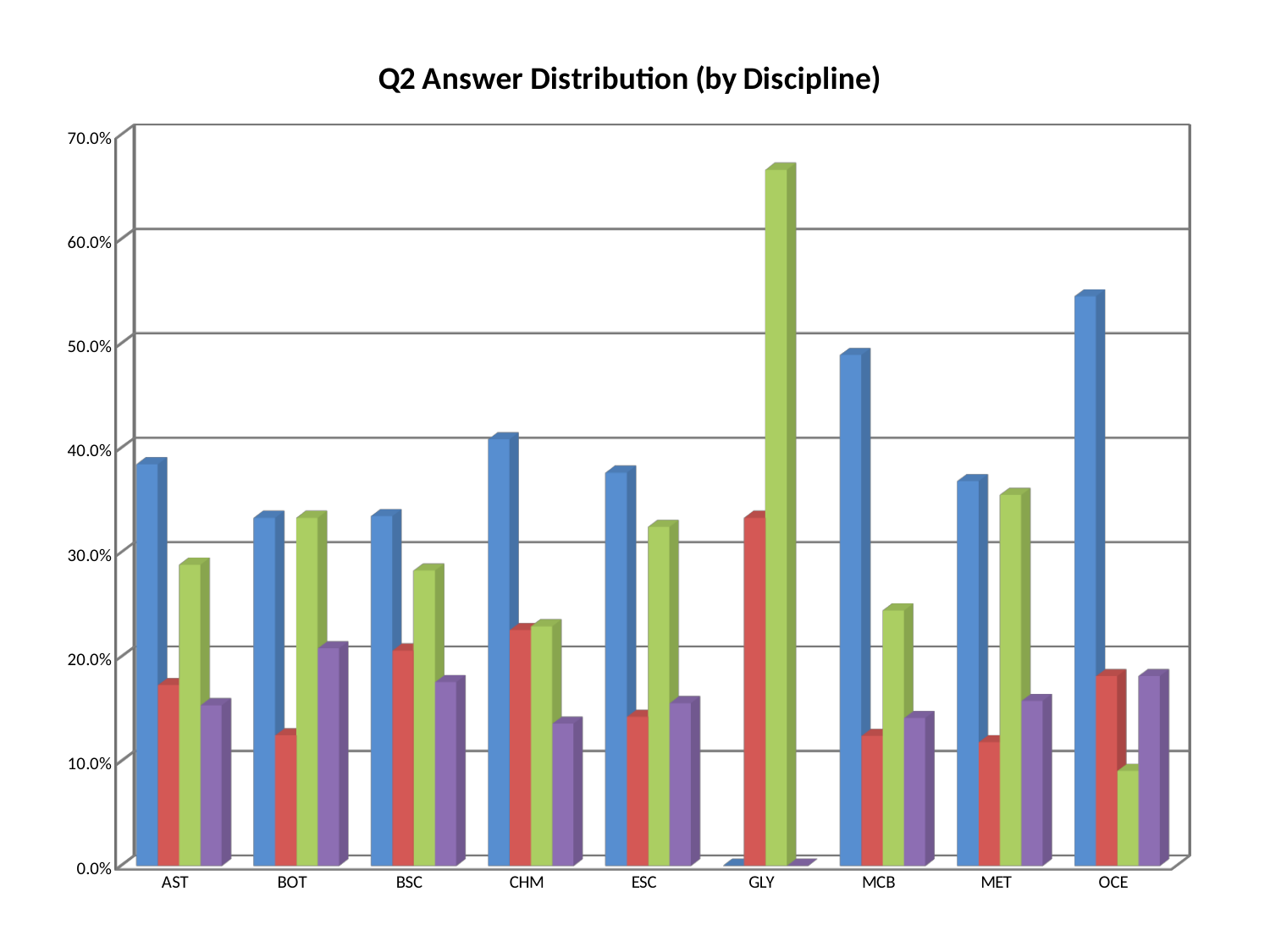
What type of chart is shown on the slide? bar chart Which discipline has the lowest blue bar? GLY How many differently coloured bars are plotted for each discipline? 4 Which discipline has the tallest red bar? GLY How many discipline categories are shown on the x axis? 9 Is the green bar for GLY greater or less than 60.0%? greater Is the red bar for BOT greater or less than 20.0%? less For OCE, which is larger, the blue bar or the green bar? the blue bar What is the title of the chart? Q2 Answer Distribution (by Discipline) Which discipline has the tallest green bar? GLY Which discipline has the tallest blue bar? OCE Is the blue bar for OCE greater or less than 50.0%? greater